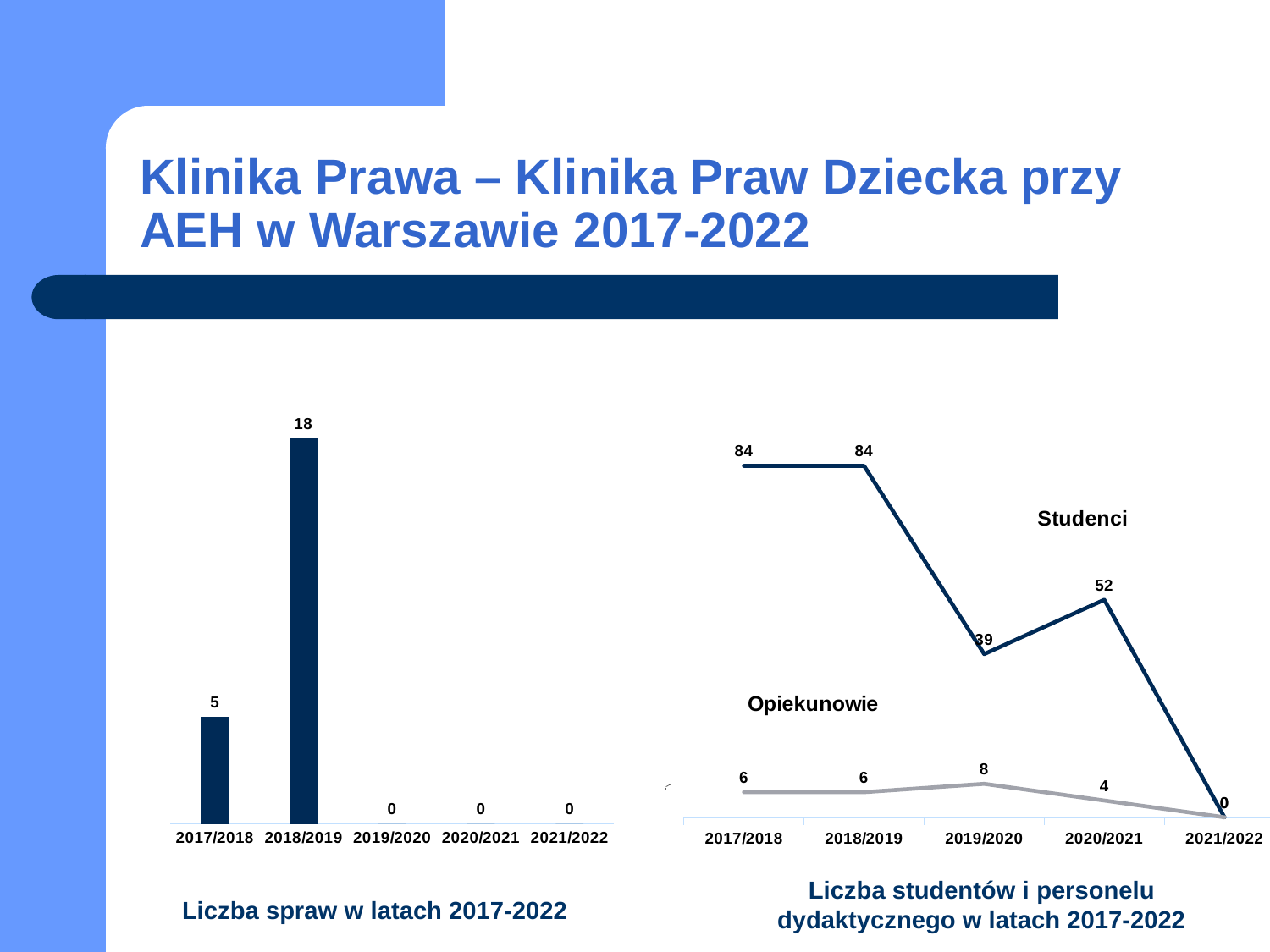
In the chart titled "Liczba spraw w latach 2017-2022", what is the difference between the values for 2018/2019 and 2017/2018? 13 In the chart titled "Liczba studentów i personelu dydaktycznego w latach 2017-2022", in which year does the Opiekunowie series reach its highest value? 2019/2020 In the chart titled "Liczba spraw w latach 2017-2022", what is the value for 2017/2018? 5 In the chart titled "Liczba spraw w latach 2017-2022", how many years are shown on the x axis? 5 What kind of chart is the one titled "Liczba studentów i personelu dydaktycznego w latach 2017-2022"? line chart In the chart titled "Liczba spraw w latach 2017-2022", which year has the highest value? 2018/2019 In the chart titled "Liczba studentów i personelu dydaktycznego w latach 2017-2022", what is the difference between the Studenci values for 2020/2021 and 2019/2020? 13 In the chart titled "Liczba studentów i personelu dydaktycznego w latach 2017-2022", which is larger in 2018/2019: Studenci or Opiekunowie? Studenci In the chart titled "Liczba spraw w latach 2017-2022", what is the value for 2018/2019? 18 In the chart titled "Liczba studentów i personelu dydaktycznego w latach 2017-2022", what is the Studenci value for 2019/2020? 39 In the chart titled "Liczba studentów i personelu dydaktycznego w latach 2017-2022", what is the Opiekunowie value for 2020/2021? 4 What kind of chart is the one titled "Liczba spraw w latach 2017-2022"? bar chart